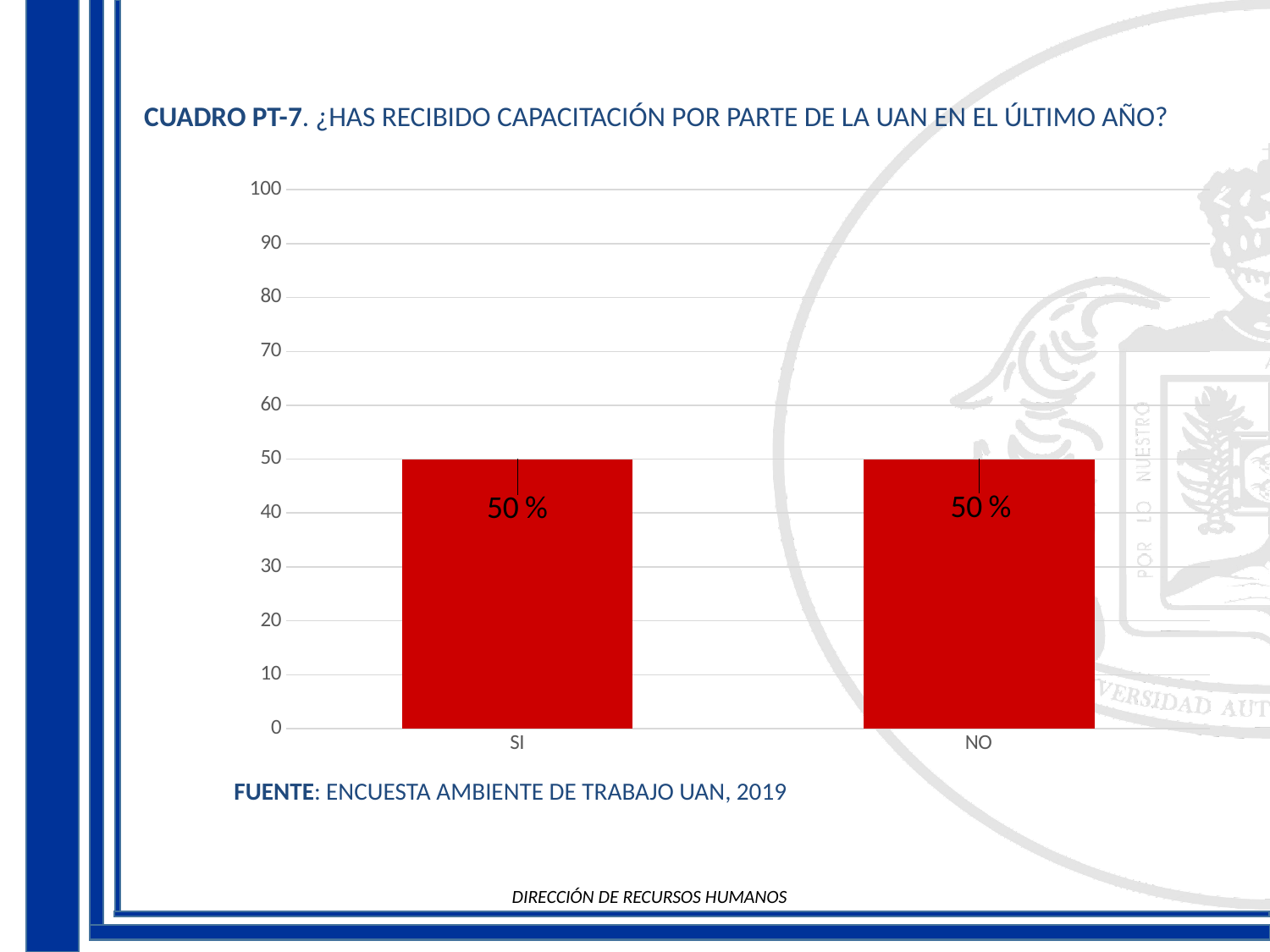
Is the value for SI greater or less than 60? less What colour are the bars in the chart? red What is the highest value shown on the vertical axis? 100 How many categories are shown on the x axis? 2 Is the value for NO greater or less than 40? greater Do the values for SI and NO differ, or are they equal? equal What kind of chart is shown on the slide? bar chart What is the value for NO? 50 % What is the difference between the values for SI and NO? 0 What is the value for SI? 50 %